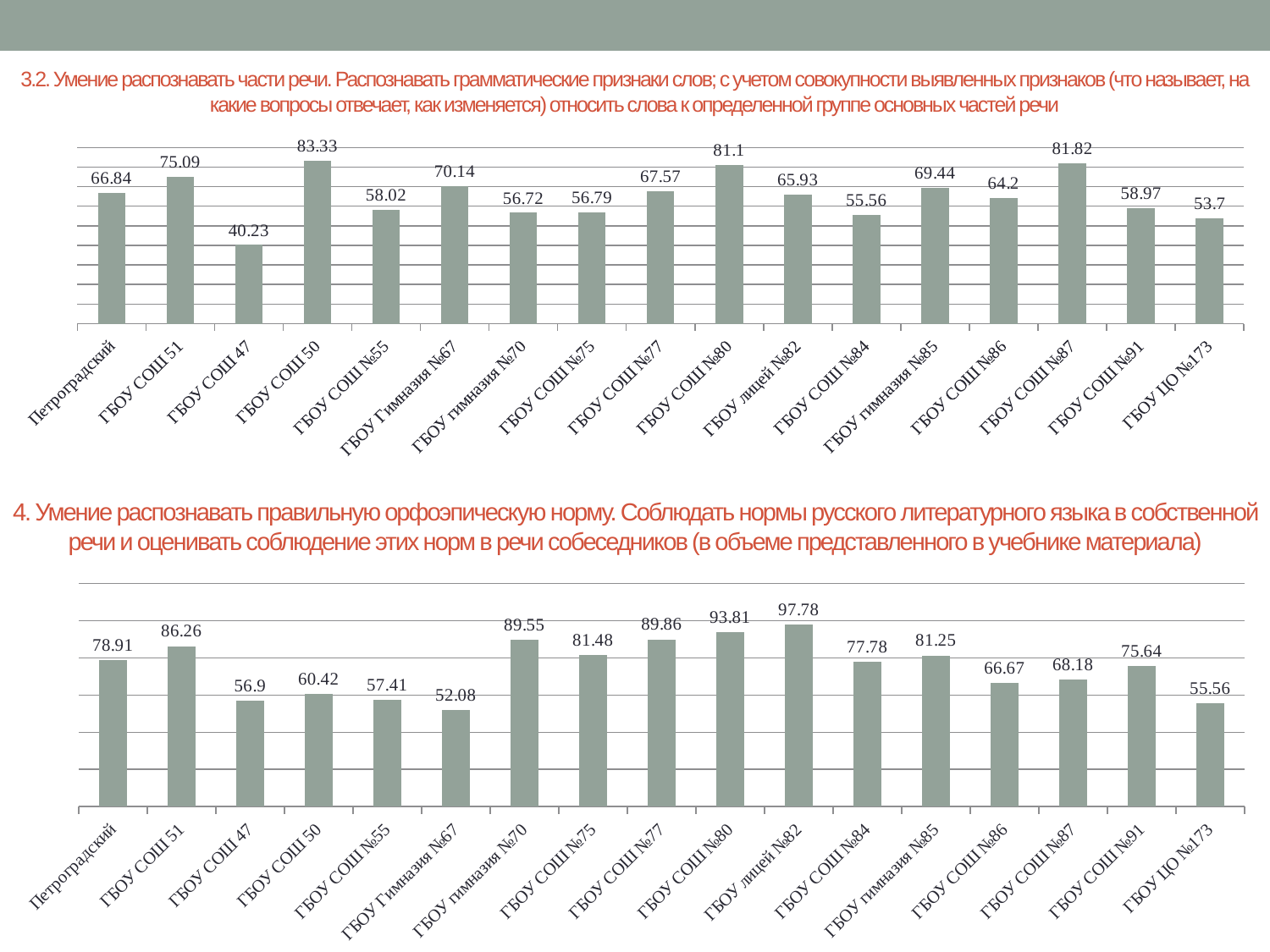
In the bottom chart, what is the value for ГБОУ лицей №82? 97.78 In the top chart, which is larger: the value for ГБОУ Гимназия №67 or the value for ГБОУ гимназия №85? ГБОУ Гимназия №67 In the top chart, which category has the lowest value? ГБОУ СОШ 47 In the bottom chart, which category has the lowest value? ГБОУ Гимназия №67 How many categories are shown in the top chart? 17 In the top chart, what is the difference between the values for ГБОУ СОШ №87 and ГБОУ СОШ №80? 0.72 What type of chart is the bottom chart? Bar chart In the top chart, what is the value for ГБОУ СОШ 47? 40.23 In the bottom chart, which category has the highest value? ГБОУ лицей №82 In the top chart, which category has the highest value? ГБОУ СОШ 50 In the bottom chart, what is the difference between the values for ГБОУ СОШ 51 and Петроградский? 7.35 In the bottom chart, which is larger: the value for ГБОУ СОШ №84 or the value for ГБОУ СОШ №91? ГБОУ СОШ №84